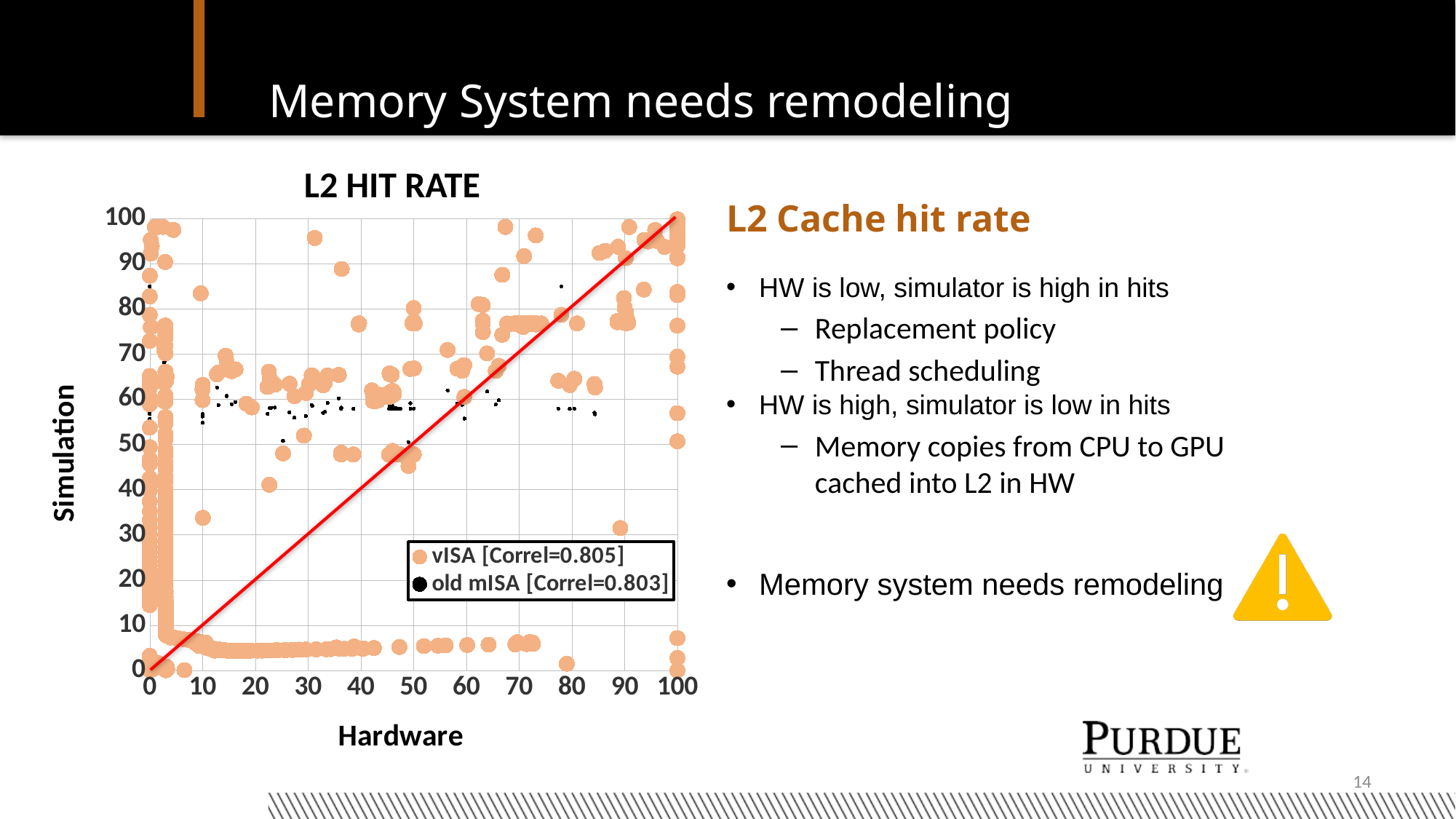
What is the label of the chart's y axis? Simulation What is the difference between the correlation values of vISA and old mISA shown in the legend? 0.002 What is the maximum value shown on the chart's y axis? 100 Which series has the higher correlation value in the legend, vISA or old mISA? vISA What is the maximum value shown on the chart's x axis? 100 What correlation value is shown in the legend for the old mISA series? 0.803 What correlation value is shown in the legend for the vISA series? 0.805 What kind of chart is shown on the slide? Scatter chart How many series does the chart's legend list? 2